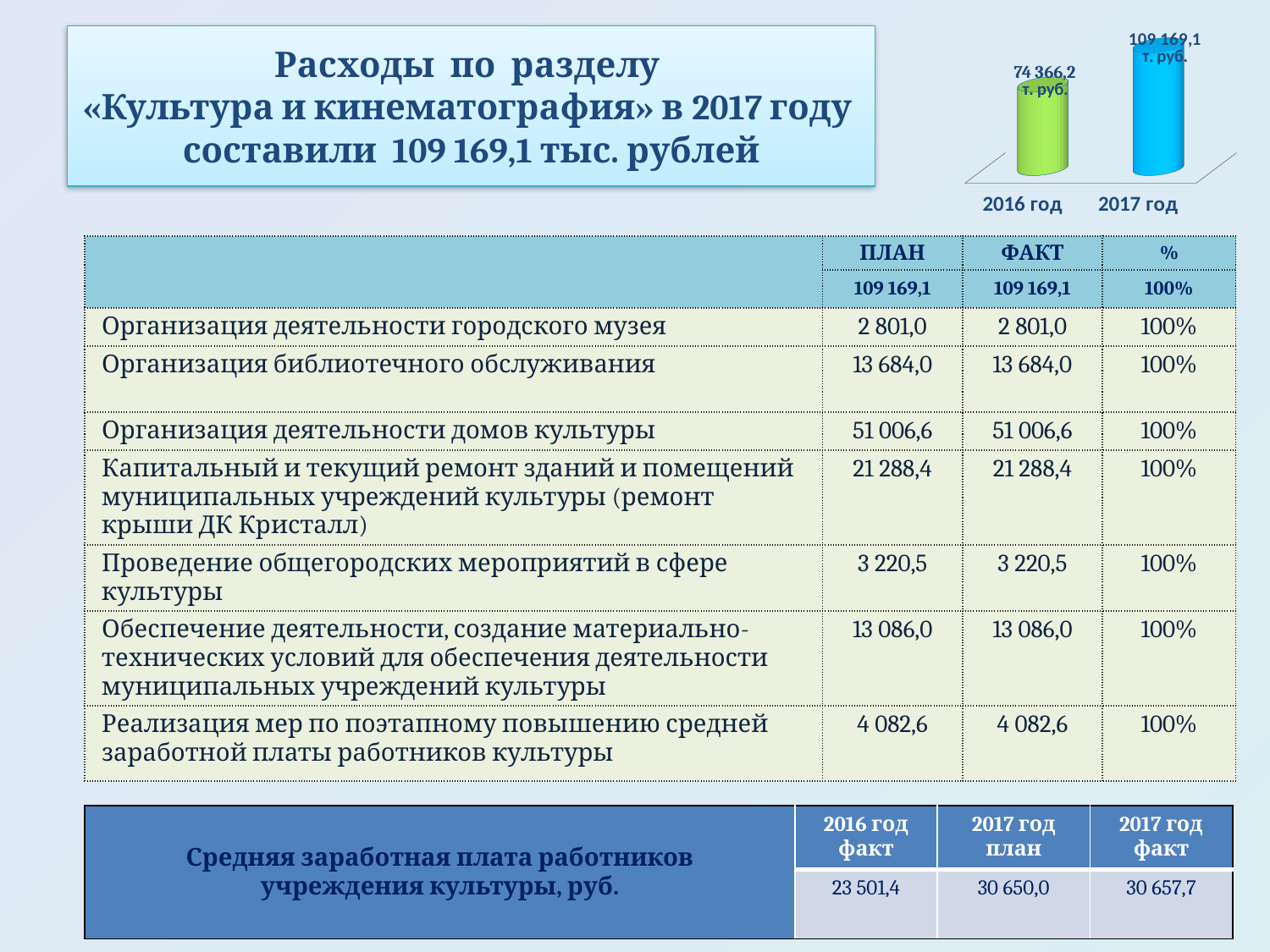
In the bar chart at the top right of the slide, what is the value for 2017 год? 109 169,1 т. руб. In the bar chart at the top right of the slide, what is the value for 2016 год? 74 366,2 т. руб. What kind of chart is shown at the top right of the slide? bar chart In the bar chart at the top right of the slide, what colour is the bar for 2016 год? green In the bar chart at the top right of the slide, which year has the lower value? 2016 год In the bar chart at the top right of the slide, is the value for 2016 год larger or smaller than the value for 2017 год? smaller How many bars are shown in the bar chart at the top right of the slide? 2 In the bar chart at the top right of the slide, do the values rise or fall from 2016 год to 2017 год? rise In the bar chart at the top right of the slide, what colour is the bar for 2017 год? blue In the bar chart at the top right of the slide, by how much does the 2017 год value exceed the 2016 год value? 34 802,9 In the bar chart at the top right of the slide, which year has the higher value? 2017 год